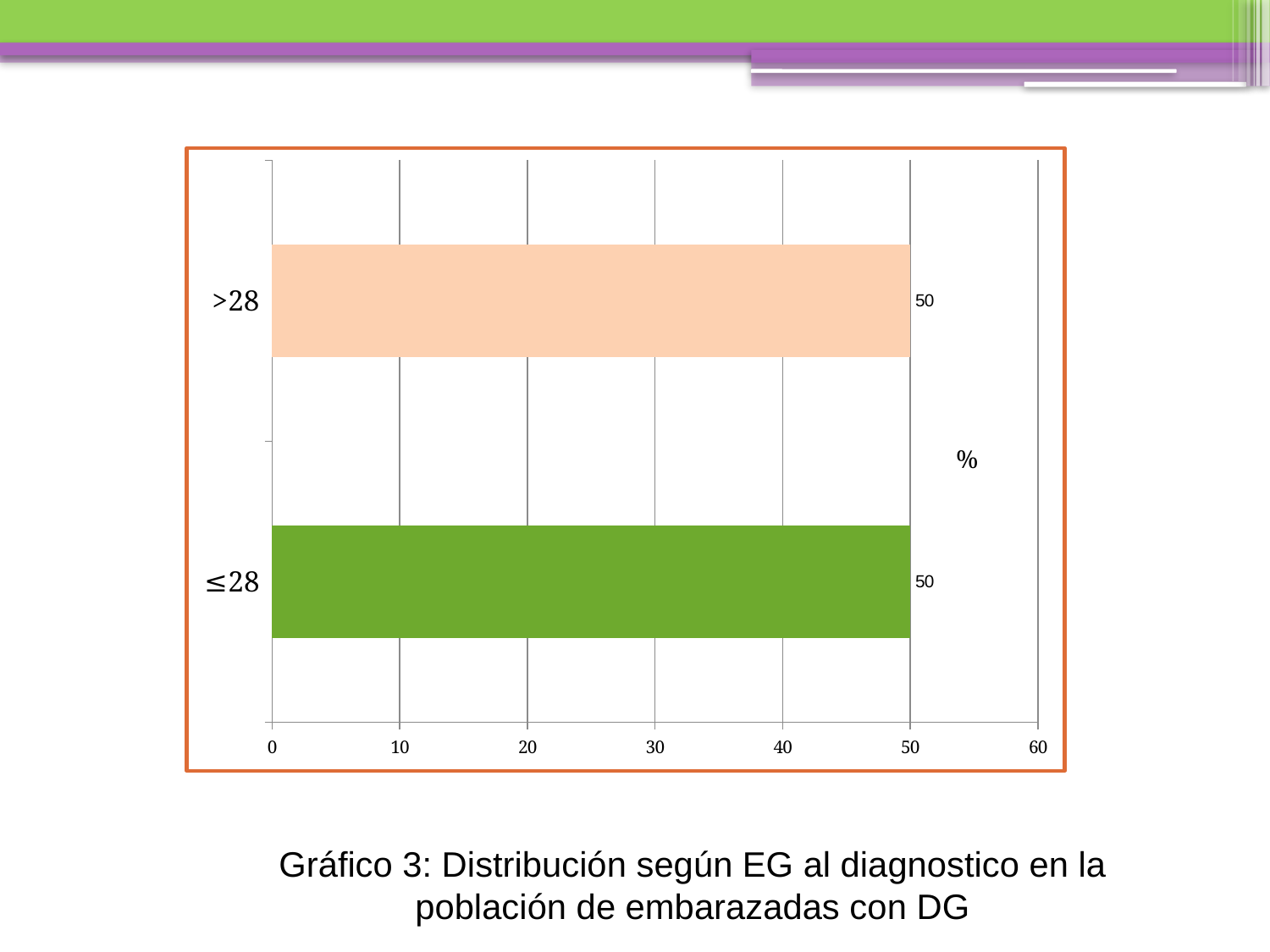
What is the total of the values for >28 and ≤28? 100 How many categories are shown on the chart? 2 What kind of chart is shown on the slide? Bar chart What is the value for the ≤28 category? 50 Is the value for ≤28 greater or less than 60? less What is the value for the >28 category? 50 What is the difference between the values for >28 and ≤28? 0 Is the value for >28 greater or less than 40? greater What unit label is shown next to the bars on the chart? % What is the maximum value shown on the horizontal axis? 60